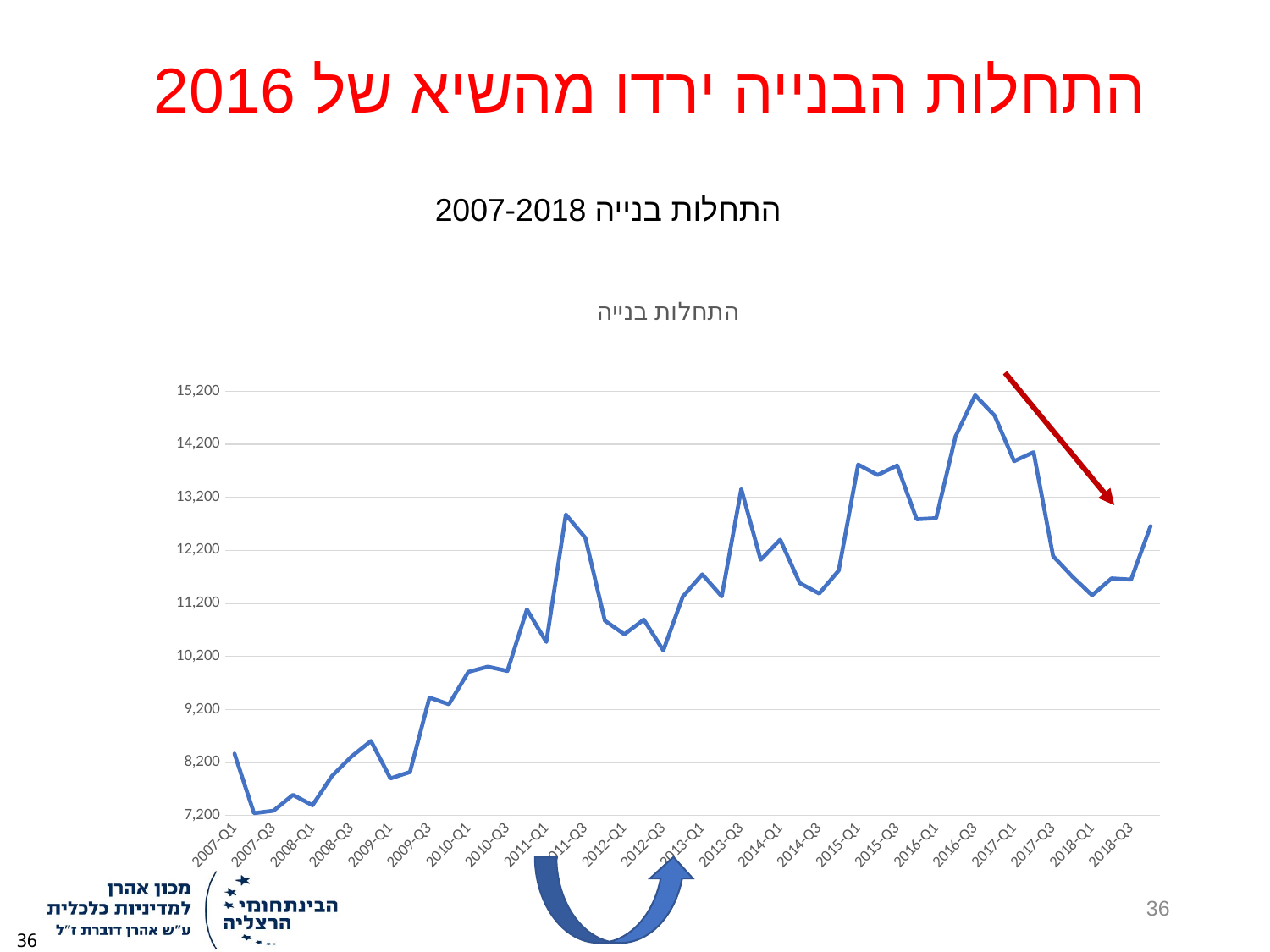
What kind of chart is shown on the slide? line chart Is the value for 2012-Q3 greater or less than 11,200? less In which quarter does the line reach its lowest value? 2007-Q2 What is the highest value shown on the vertical axis? 15,200 In which quarter does the line reach its highest value? 2016-Q3 Which is larger, the value for 2016-Q3 or the value for 2017-Q3? 2016-Q3 Is the value for 2016-Q3 greater or less than 14,200? greater Do the values rise or fall from 2016-Q3 to 2018-Q1? fall Is the value for 2009-Q1 greater or less than 8,200? less Which is larger, the value for 2011-Q3 or the value for 2012-Q3? 2011-Q3